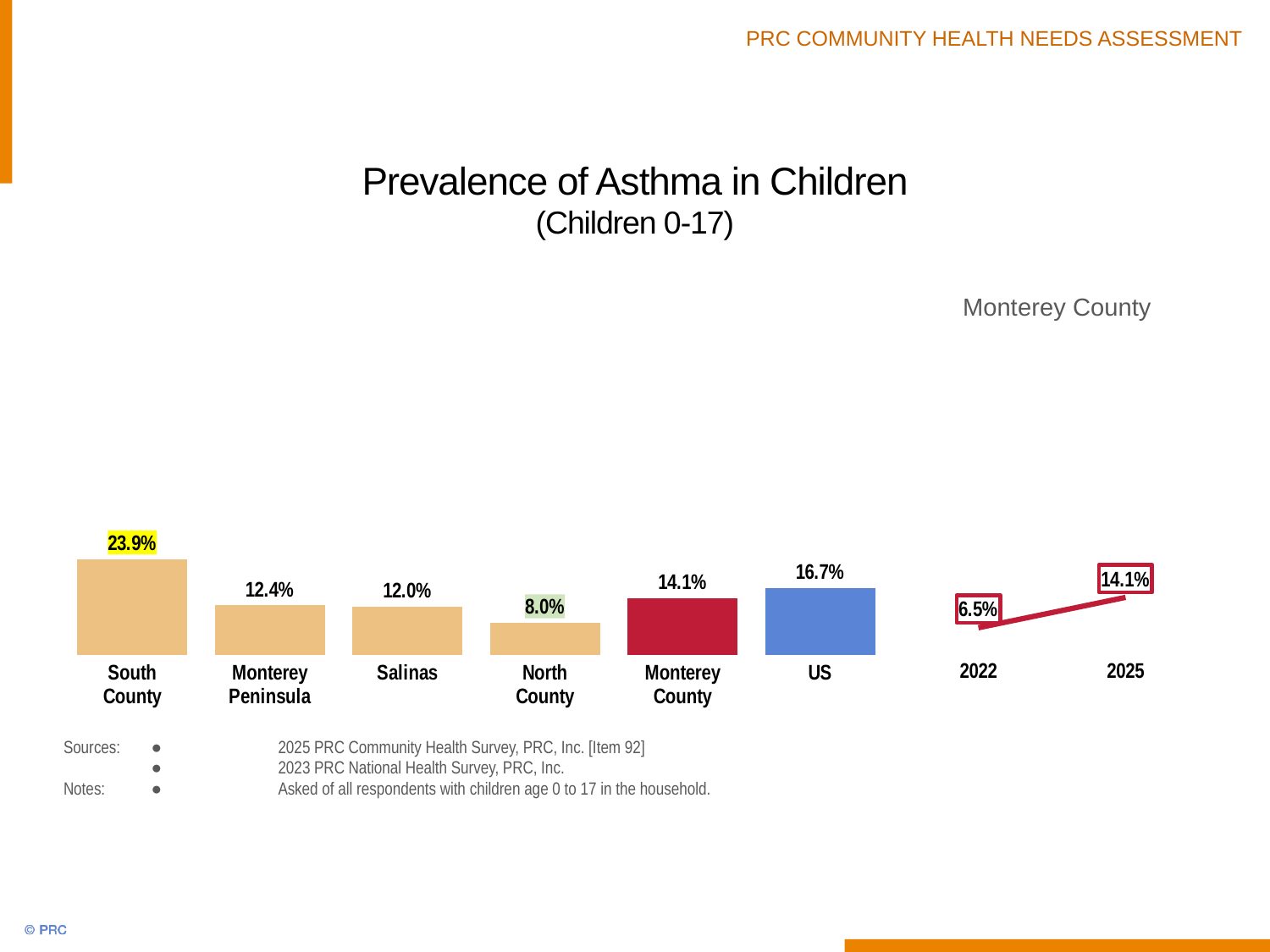
In the line chart on the right, what is the difference between the 2025 and 2022 values? 7.6 percentage points In the bar chart, which area has the lowest prevalence of asthma in children? North County What kind of chart is the chart on the left showing the areas? Bar chart How many areas are shown in the bar chart? 6 In the bar chart, which is larger, the value for Monterey Peninsula or the value for Salinas? Monterey Peninsula In the bar chart, what is the value for North County? 8.0% In the bar chart, which area has the highest prevalence of asthma in children? South County In the line chart on the right, did the value rise or fall from 2022 to 2025? Rise In the bar chart, what is the prevalence of asthma in children for South County? 23.9% In the bar chart, what is the value for the US? 16.7% In the bar chart, what is the difference between the South County value and the Monterey County value? 9.8 percentage points In the line chart on the right, what was the Monterey County value in 2022? 6.5%